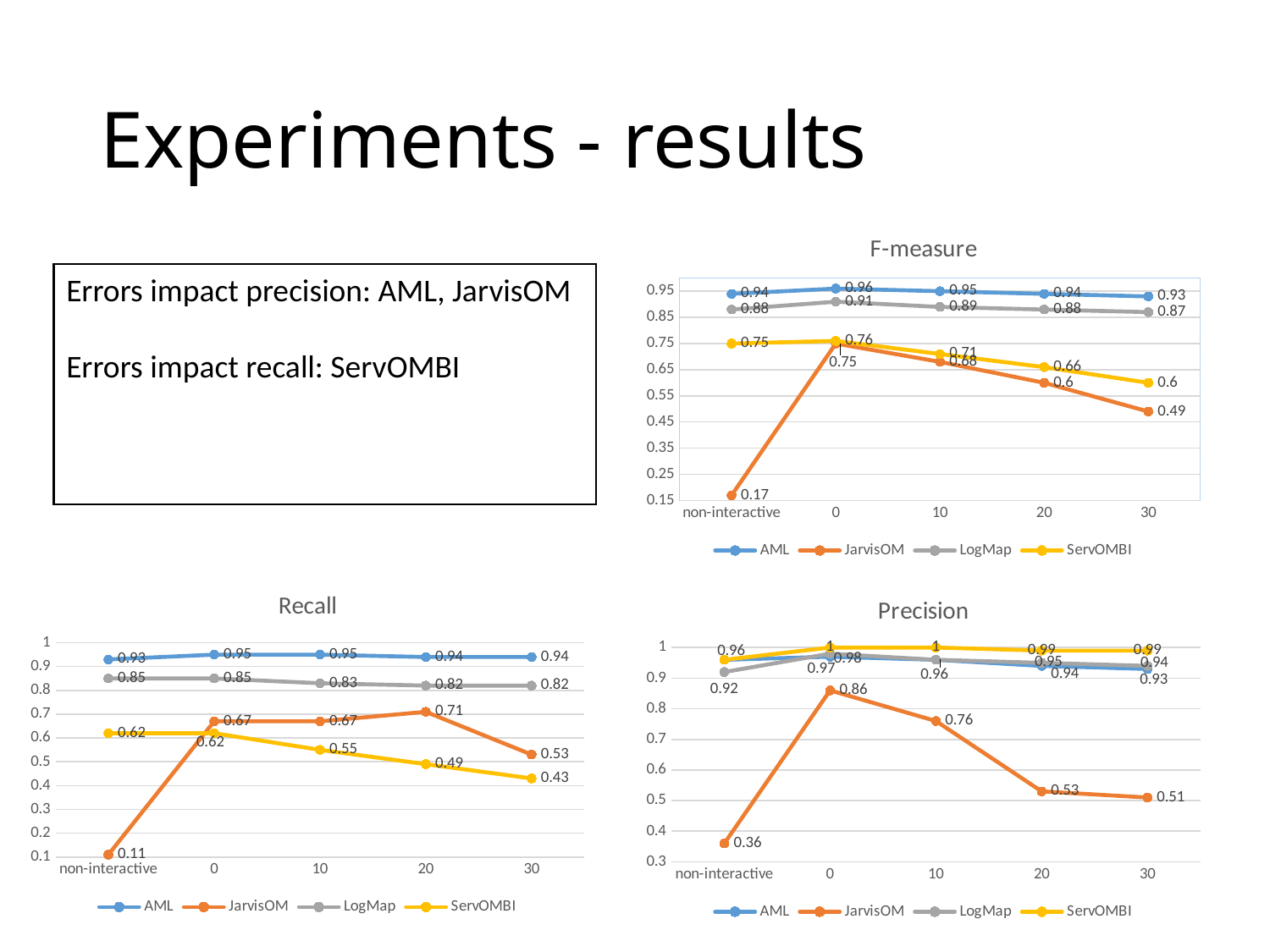
What kind of chart is the Precision chart? line chart How many series does the legend of the Recall chart list? 4 In the F-measure chart, what is the value for JarvisOM at non-interactive? 0.17 In the Precision chart, what is the value for JarvisOM at 0? 0.86 In the F-measure chart, which series has the highest value at 0? AML In the Precision chart, is the value for JarvisOM at non-interactive greater or less than 0.4? less In the F-measure chart, what is the difference between AML and LogMap at 10? 0.06 In the F-measure chart, what is the value for ServOMBI at 30? 0.6 In the Recall chart, which series has the lowest value at 30? ServOMBI In the Precision chart, what is the difference between JarvisOM at 10 and JarvisOM at 20? 0.23 In the Recall chart, does the ServOMBI series rise or fall from 0 to 30? fall In the Recall chart, what is the value for JarvisOM at 20? 0.71